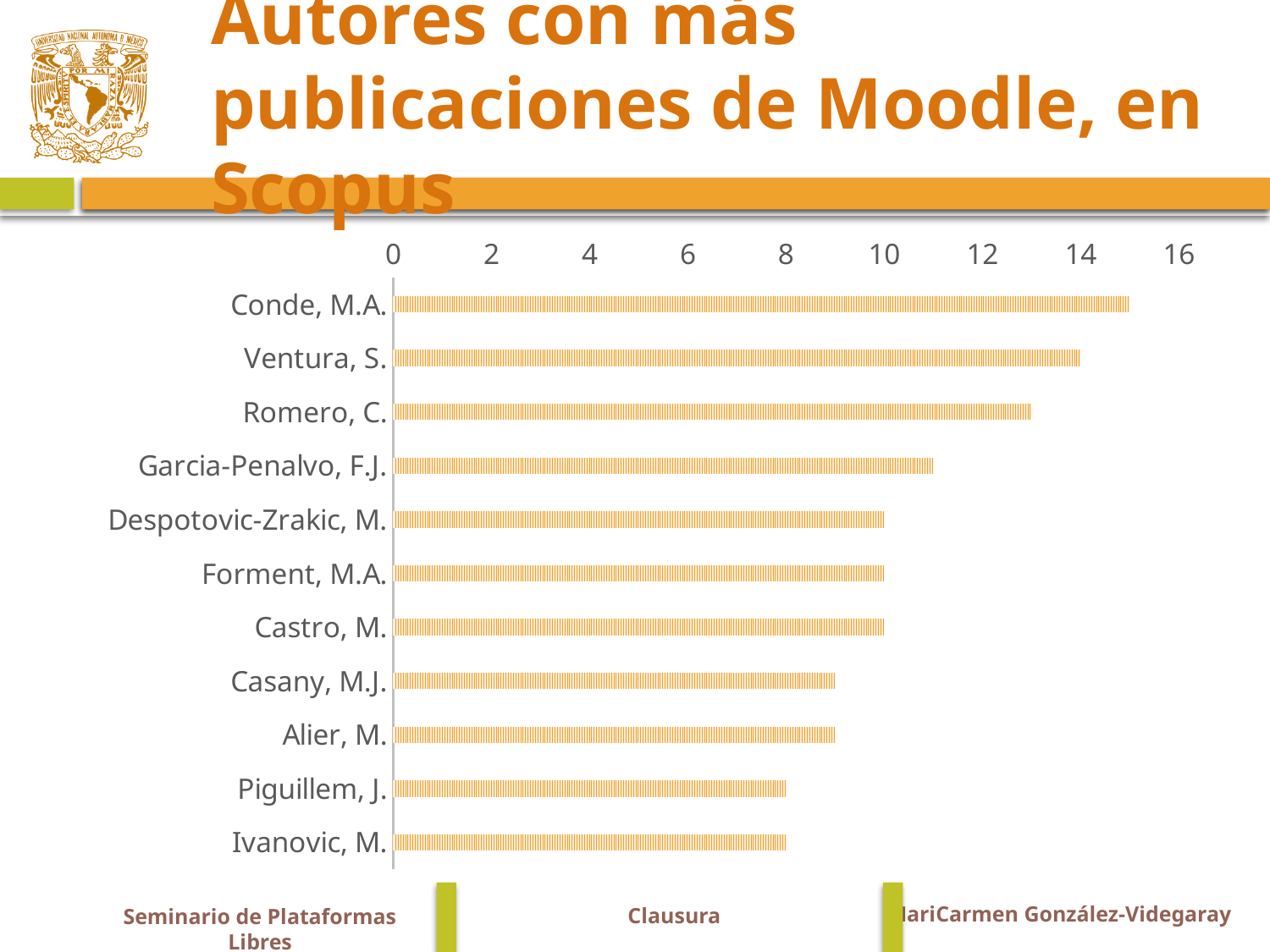
What is the title of the chart on the slide? Autores con más publicaciones de Moodle, en Scopus What is the value for Ventura, S.? 14 How many authors are listed on the chart? 11 Is the value for Garcia-Penalvo, F.J. greater or less than 12? less Is the value for Romero, C. greater or less than 12? greater Which author has the highest number of publications on the chart? Conde, M.A. Which has a larger value, Conde, M.A. or Romero, C.? Conde, M.A. Is the value for Conde, M.A. greater or less than 14? greater What is the value for Piguillem, J.? 8 What is the difference between the values for Ventura, S. and Castro, M.? 4 What kind of chart is shown on the slide? bar chart What is the value for Castro, M.? 10